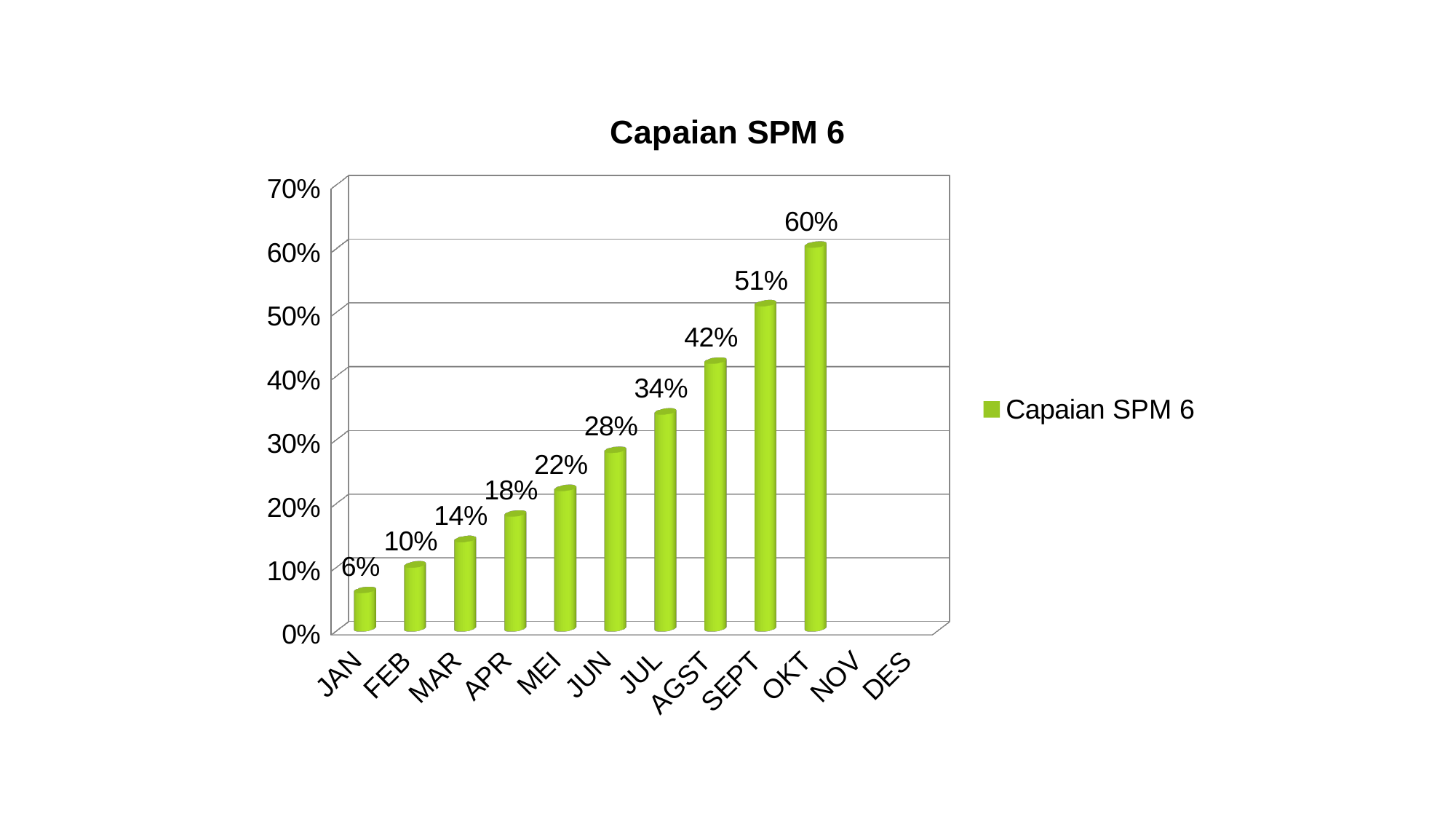
What is the value for JUL? 34% Among the months with a plotted bar, which has the lowest value? JAN What kind of chart is shown? Bar chart What is the value for MAR? 14% What is the difference between the values for JUN and FEB? 18% What is the difference between the values for OKT and SEPT? 9% Which month has the highest value? OKT How many months are labelled on the x axis? 12 Which is larger, the value for AGST or the value for MEI? AGST What is the value for SEPT? 51% Do the values rise or fall from JAN to OKT? Rise How many series does the legend list? 1